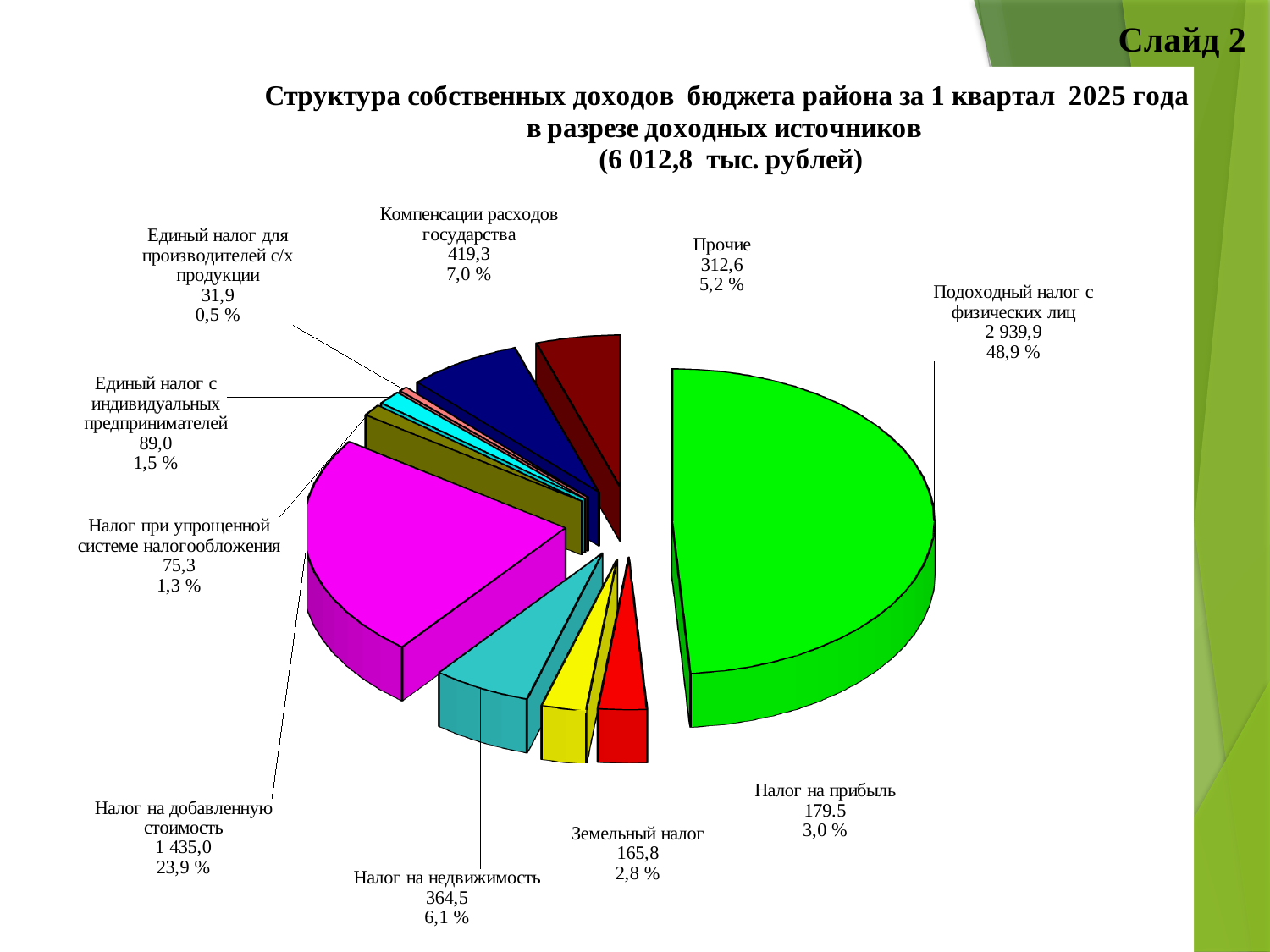
Which category has the smallest slice of the pie? Единый налог для производителей с/х продукции How many categories (income sources) does the pie chart show? 10 What is the difference between the values for "Налог на прибыль" and "Земельный налог"? 13,7 Which is larger: "Прочие" or "Налог на недвижимость"? Налог на недвижимость What share of the pie does "Налог на добавленную стоимость" have? 23,9 % What is the value for "Компенсации расходов государства"? 419,3 What is the value for "Единый налог с индивидуальных предпринимателей"? 89,0 What type of chart is shown on the slide? pie chart What share of the pie does "Налог на недвижимость" have? 6,1 % What total amount is stated in the chart title? 6 012,8 тыс. рублей Which category has the largest slice of the pie? Подоходный налог с физических лиц What is the value for "Подоходный налог с физических лиц"? 2 939,9